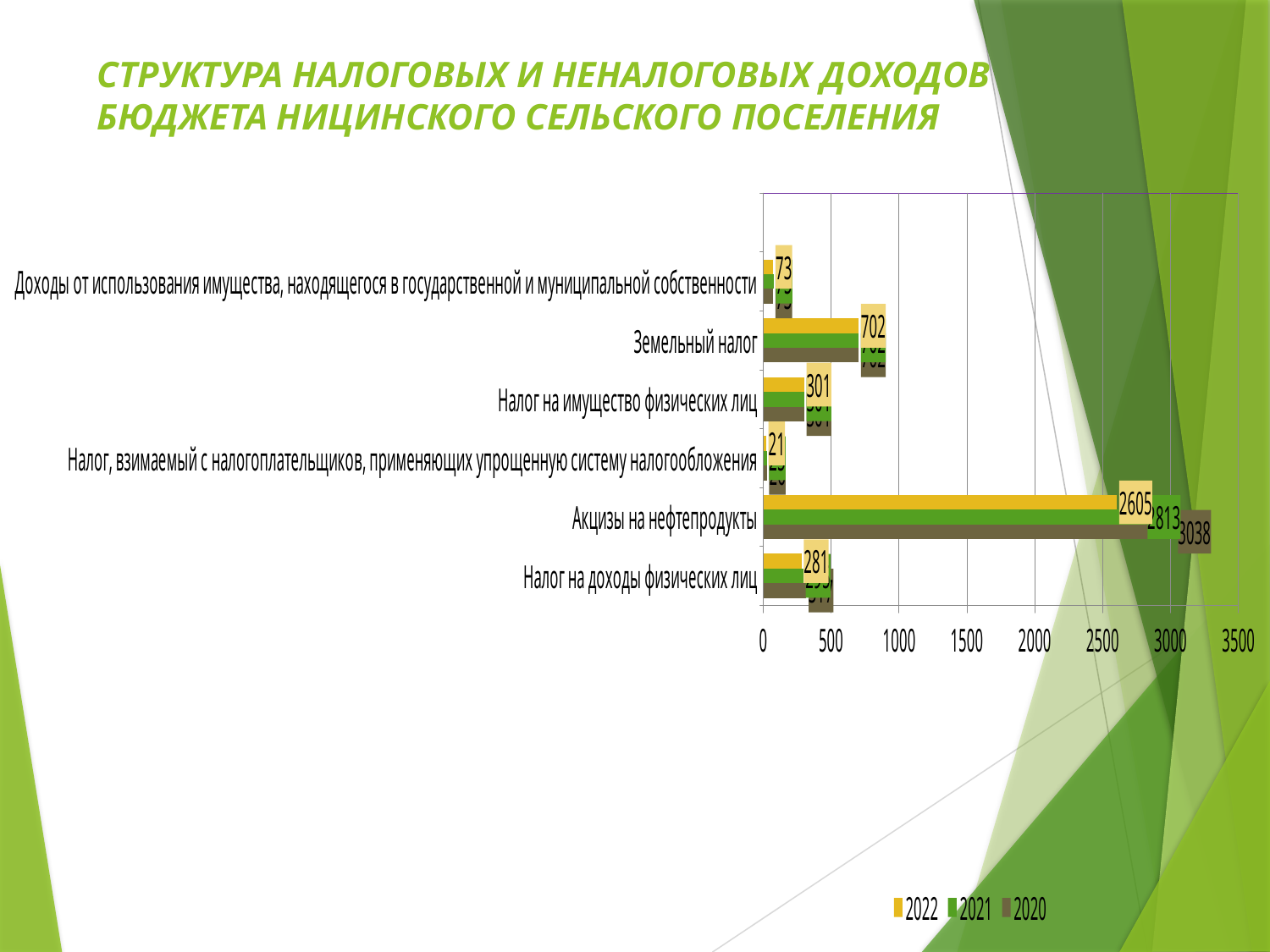
What is the difference between the 2020 and 2022 values for Акцизы на нефтепродукты? 433 Which category has the lowest 2022 value? Налог, взимаемый с налогоплательщиков, применяющих упрощенную систему налогообложения How many series does the legend list? 3 What is the 2020 value for Акцизы на нефтепродукты? 3038 Which category has the highest 2022 value? Акцизы на нефтепродукты What is the 2022 value for Налог на доходы физических лиц? 281 How many categories are shown on the chart? 6 What is the 2022 value for Налог на имущество физических лиц? 301 What is the 2021 value for Акцизы на нефтепродукты? 2813 What is the 2022 value for Акцизы на нефтепродукты? 2605 What is the 2022 value for Земельный налог? 702 What type of chart is shown on the slide? bar chart